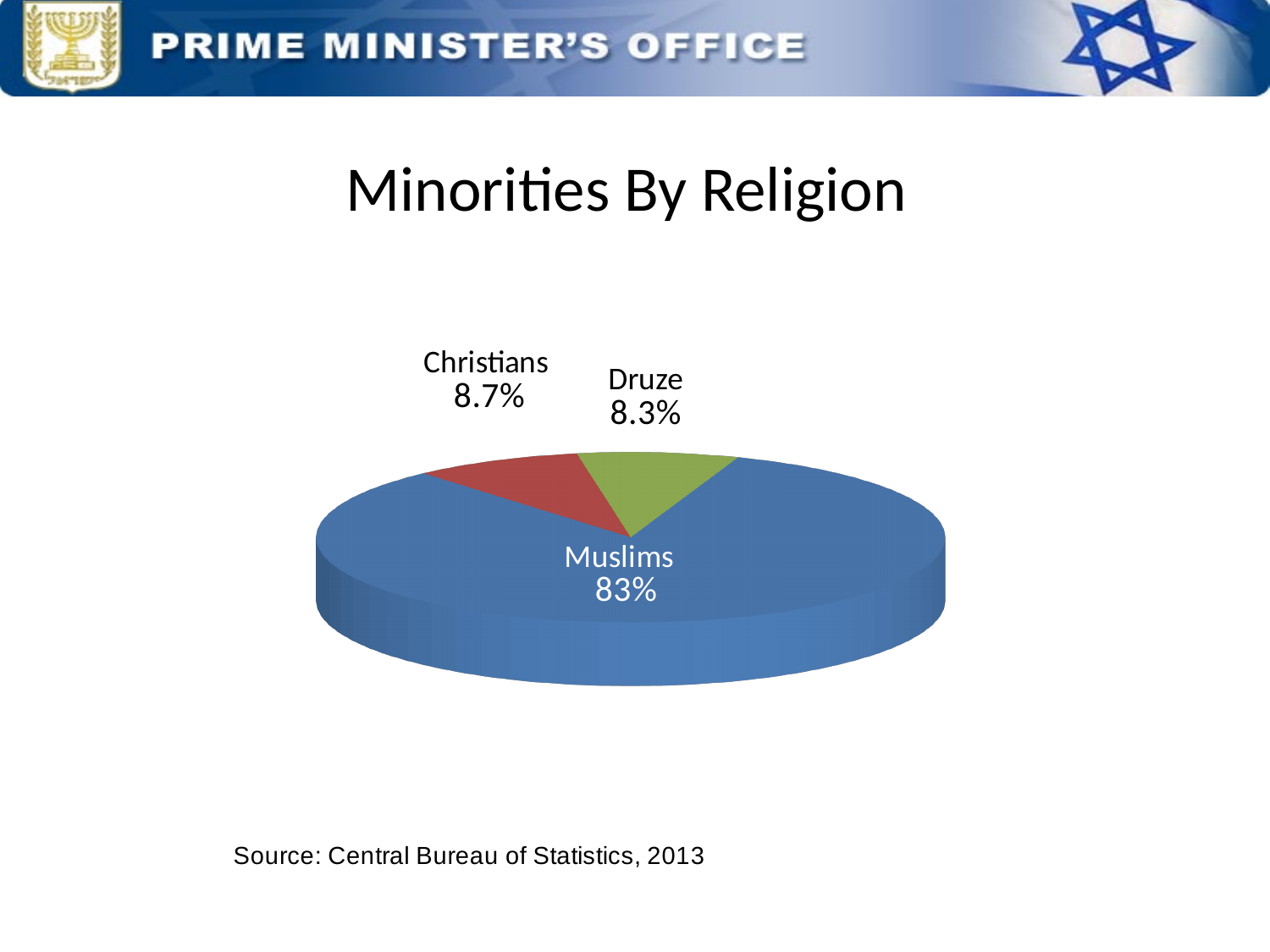
What share of the pie do Muslims represent? 83% How many religious groups are shown in the pie chart? 3 What is the difference in percentage points between Muslims and Christians? 74.3 What is the difference in percentage points between Christians and Druze? 0.4 What colour is the Druze slice of the pie? Green Which religion has the largest slice of the pie? Muslims What is the title of the chart? Minorities By Religion What percentage is shown for Christians? 8.7% What percentage is shown for Druze? 8.3% What type of chart is shown on the slide? Pie chart Which religion has the smallest slice of the pie? Druze Which is larger, the share for Christians or the share for Druze? Christians